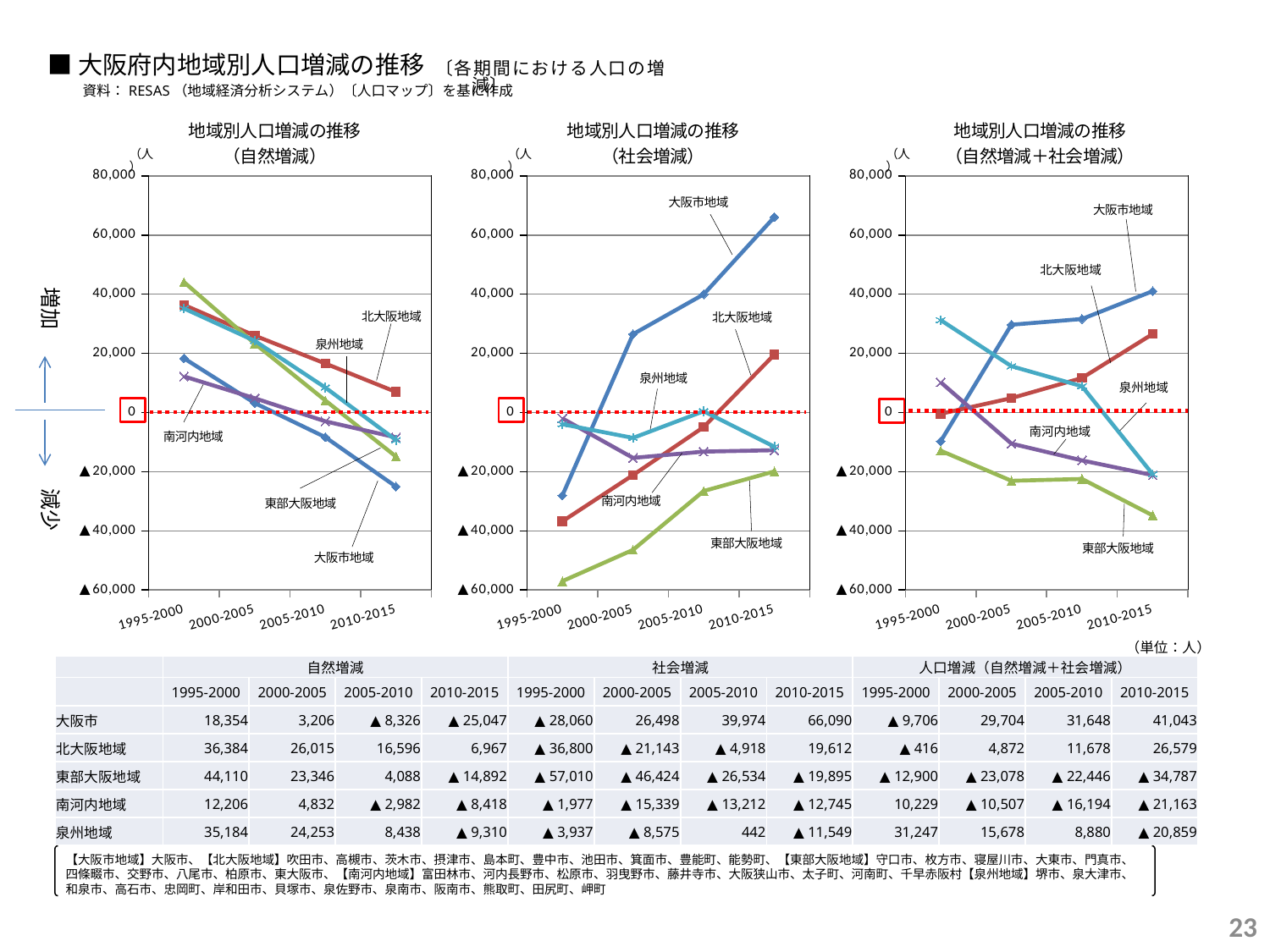
In the 社会増減 chart (middle), does the 大阪市地域 line rise or fall from 1995-2000 to 2010-2015? Rise What is the title of the middle chart? 地域別人口増減の推移（社会増減） How many regions are plotted as separate lines in each chart? 5 In the 自然増減＋社会増減 chart (right), which region has the highest value in 2010-2015? 大阪市地域 How many time periods are plotted along the x axis of each chart? 4 In the 自然増減 chart (left), which is larger in 1995-2000: 東部大阪地域 or 北大阪地域? 東部大阪地域 In the 社会増減 chart (middle), what is the value for 大阪市地域 in 2010-2015? 66,090 In the 自然増減 chart (left), what is the value for 東部大阪地域 in 1995-2000? 44,110 In the 自然増減＋社会増減 chart (right), which region has the lowest value in 2010-2015? 東部大阪地域 In the 自然増減＋社会増減 chart (right), is the value for 北大阪地域 in 2010-2015 greater or less than 20,000? greater In the 社会増減 chart (middle), how much higher is the 大阪市地域 value in 2010-2015 than in 2005-2010? 26,116 What kind of chart is used in the three charts on the slide? Line chart